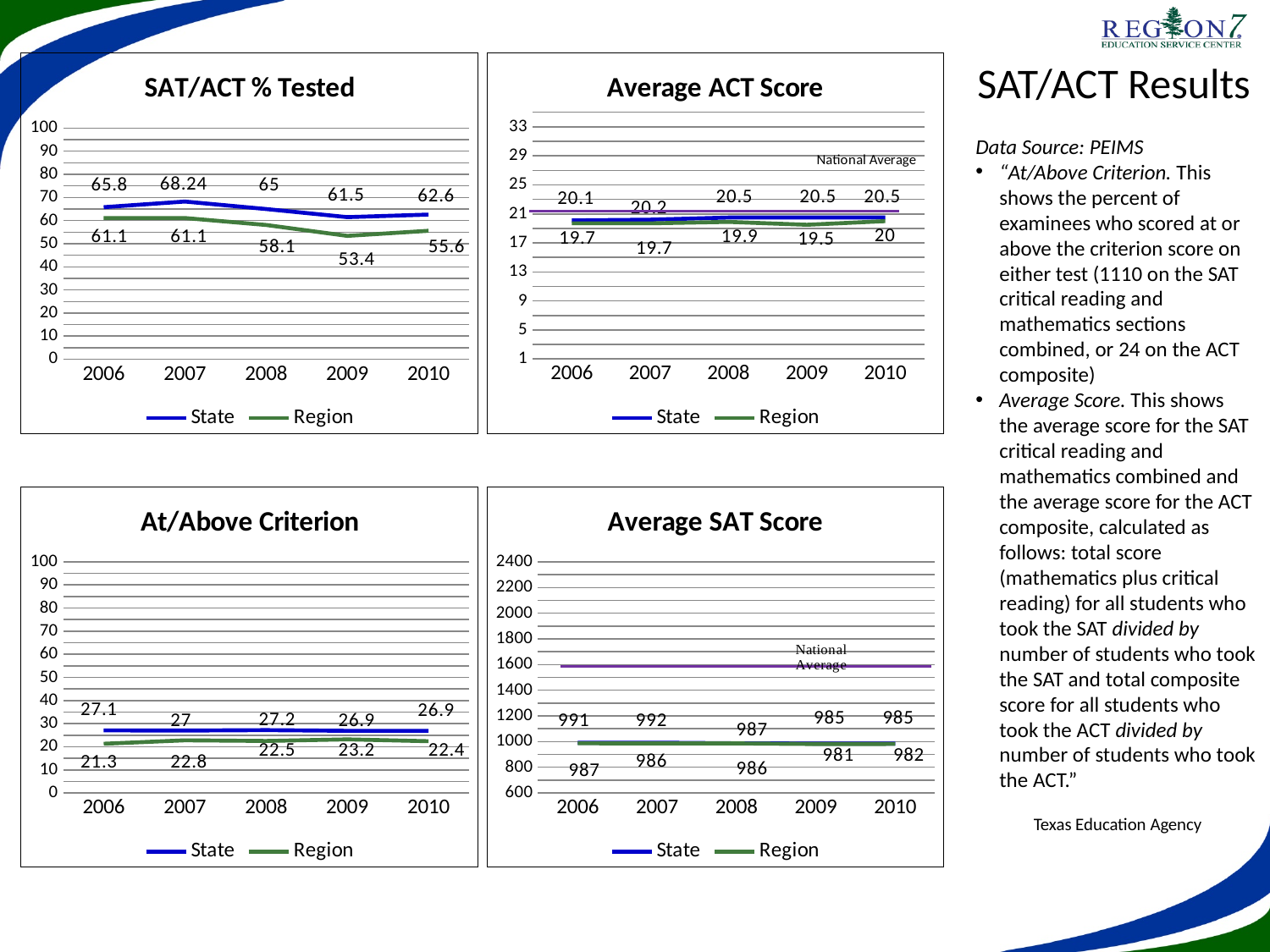
In the Average ACT Score chart, which year has the lowest Region value? 2009 In the SAT/ACT % Tested chart, which year has the lowest Region value? 2009 What kind of chart is the SAT/ACT % Tested chart? Line chart In the Average SAT Score chart, which is larger in 2009, the State value or the Region value? State In the SAT/ACT % Tested chart, what is the State value for 2007? 68.24 In the At/Above Criterion chart, what is the Region value for 2009? 23.2 In the Average ACT Score chart, is the National Average line greater or less than 17? greater In the Average SAT Score chart, is the National Average line greater or less than 1400? greater In the SAT/ACT % Tested chart, what is the difference between the State and Region values in 2009? 8.1 In the Average SAT Score chart, what is the State value for 2006? 991 In the Average ACT Score chart, what is the Region value for 2010? 20 In the At/Above Criterion chart, which year has the highest Region value? 2009